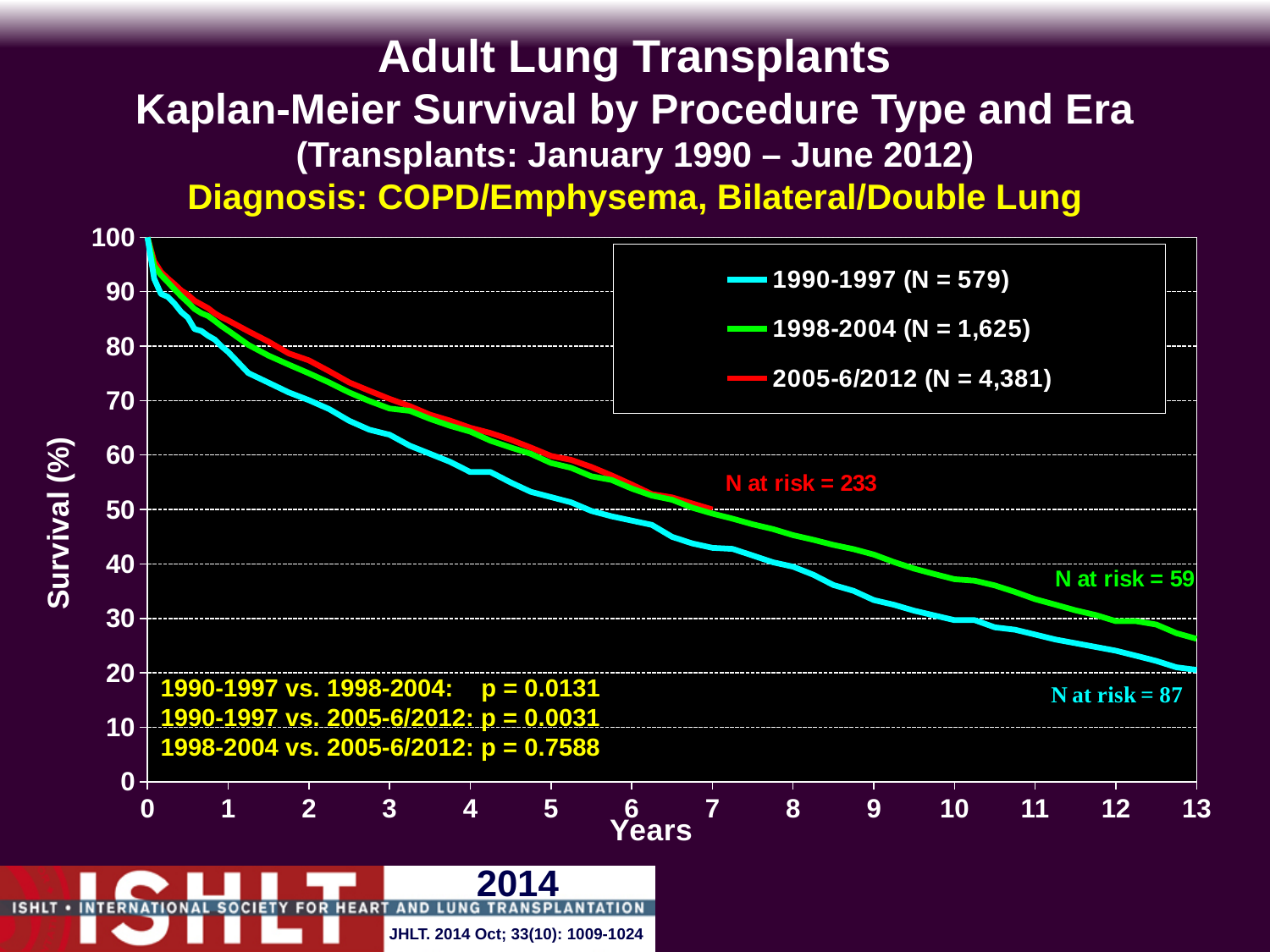
Is the survival for 2005-6/2012 at 1 year greater or less than 80? greater What kind of chart is shown on the slide? line chart What is the N at risk shown for the 1990-1997 curve? 87 At 10 years, which curve is higher: 1998-2004 or 1990-1997? 1998-2004 How many series does the legend list? 3 Do the survival curves rise or fall as years increase? fall Which era has the lowest survival at 5 years? 1990-1997 What is the p-value shown for 1998-2004 vs. 2005-6/2012? p = 0.7588 Is the survival for 1998-2004 at 13 years greater or less than 30? less What is the N at risk shown for the 2005-6/2012 curve? 233 What is the N at risk shown for the 1998-2004 curve? 59 Is the survival for 1990-1997 at 5 years greater or less than 60? less